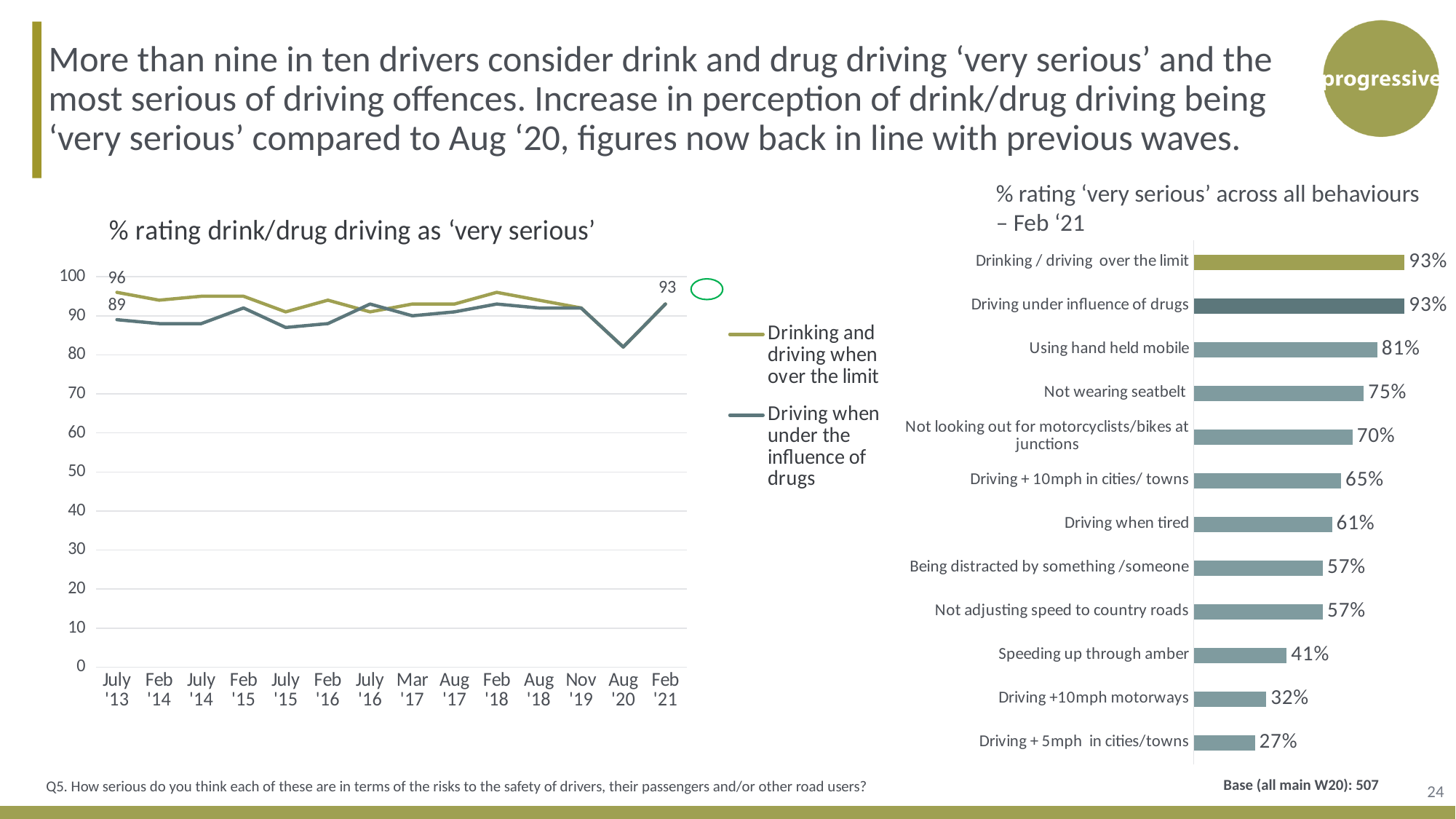
In the chart '% rating drink/drug driving as ‘very serious’', how many time points are shown on the x axis? 14 What kind of chart is '% rating drink/drug driving as ‘very serious’'? Line chart In the chart '% rating ‘very serious’ across all behaviours – Feb ‘21', what is the difference between 'Not wearing seatbelt' and 'Driving when tired'? 14% In the chart '% rating drink/drug driving as ‘very serious’', how many series does the legend list? 2 In the chart '% rating ‘very serious’ across all behaviours – Feb ‘21', which is larger: 'Speeding up through amber' or 'Driving +10mph motorways'? Speeding up through amber In the chart '% rating ‘very serious’ across all behaviours – Feb ‘21', how many behaviours are listed? 12 In the chart '% rating drink/drug driving as ‘very serious’', what value is shown for 'Driving when under the influence of drugs' in July '13? 89 In the chart '% rating ‘very serious’ across all behaviours – Feb ‘21', what is the value for 'Using hand held mobile'? 81% In the chart '% rating drink/drug driving as ‘very serious’', what value is shown for 'Driving when under the influence of drugs' in Feb '21? 93 In the chart '% rating ‘very serious’ across all behaviours – Feb ‘21', which behaviour has the lowest value? Driving + 5mph in cities/towns In the chart '% rating drink/drug driving as ‘very serious’', what value is shown for 'Drinking and driving when over the limit' in July '13? 96 In the chart '% rating drink/drug driving as ‘very serious’', is the value for 'Driving when under the influence of drugs' in Aug '20 greater or less than 90? less